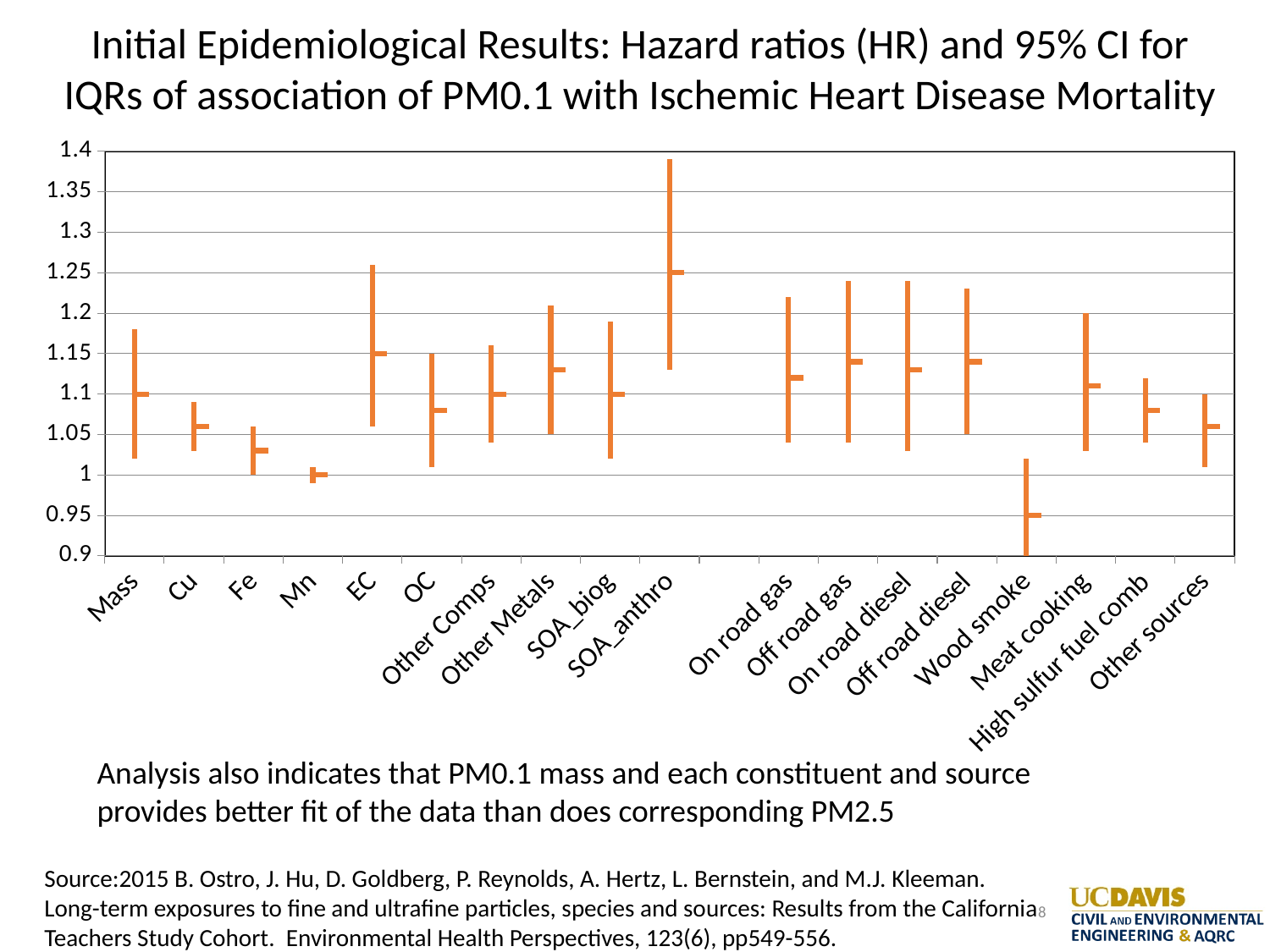
Is the upper end of the 95% CI for SOA_anthro greater or less than 1.35? greater What are the minimum and maximum values shown on the y axis? 0.9 and 1.4 Which has the larger hazard ratio, Wood smoke or Meat cooking? Meat cooking How many labeled categories are shown on the x axis? 18 Is the hazard ratio for Mn greater or less than 1.05? less Which category has the highest hazard ratio on the chart? SOA_anthro Which category has the lowest hazard ratio on the chart? Wood smoke Is the hazard ratio for Wood smoke greater or less than 1? less Which has the larger hazard ratio, EC or OC? EC Which has the larger hazard ratio, Mass or Mn? Mass